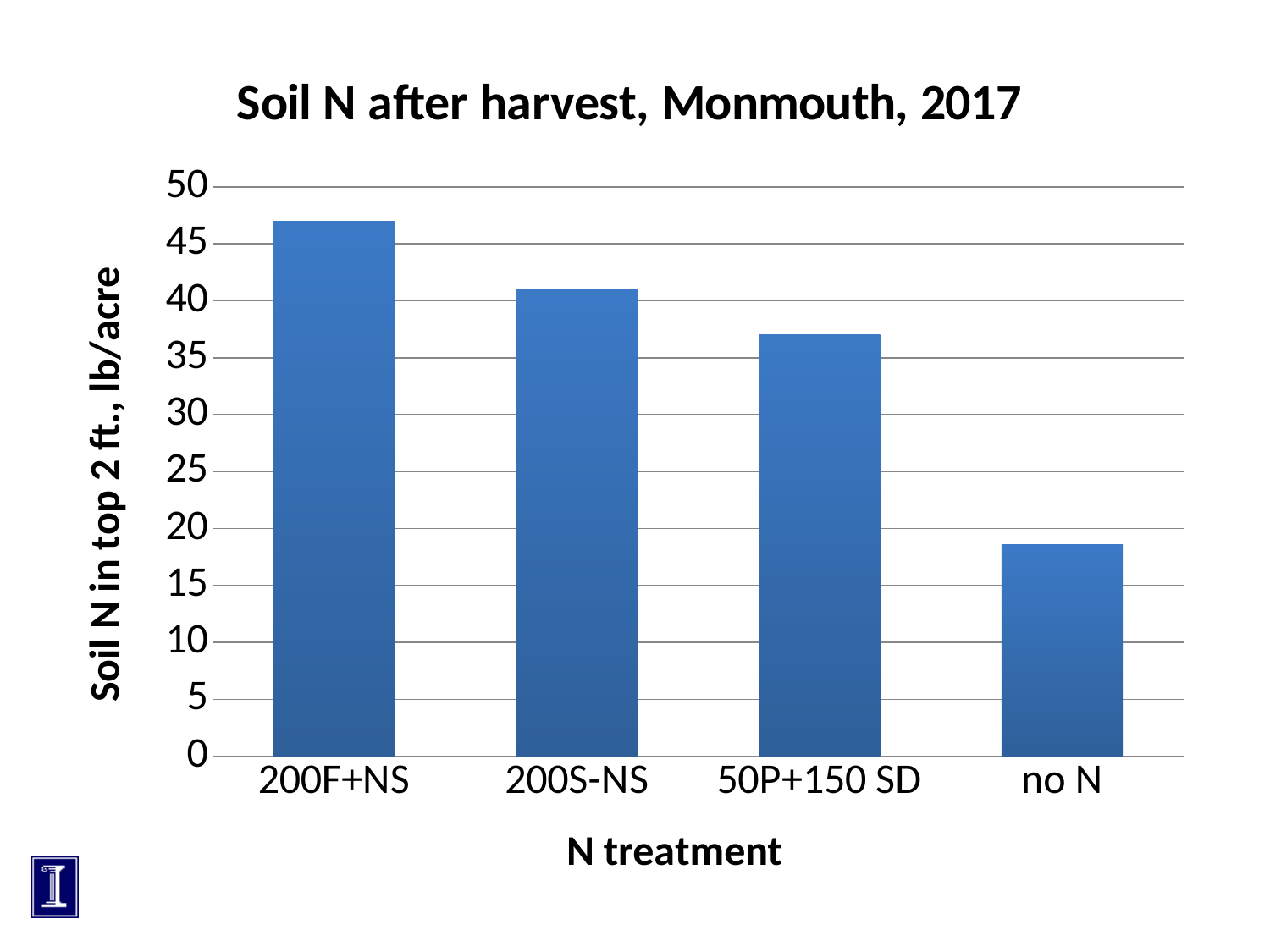
Is the value for 200S-NS greater or less than 45? less What type of chart is shown on the slide? bar chart Is the value for 50P+150 SD greater or less than 35? greater Which N treatment has the highest soil N? 200F+NS Which has a larger soil N value, 200S-NS or 50P+150 SD? 200S-NS How many N treatments are plotted on the chart? 4 Is the value for 200F+NS greater or less than 45? greater What is the label of the y axis? Soil N in top 2 ft., lb/acre Do the soil N values rise or fall moving from left to right across the treatments? fall What is the title of the chart? Soil N after harvest, Monmouth, 2017 Which N treatment has the lowest soil N? no N